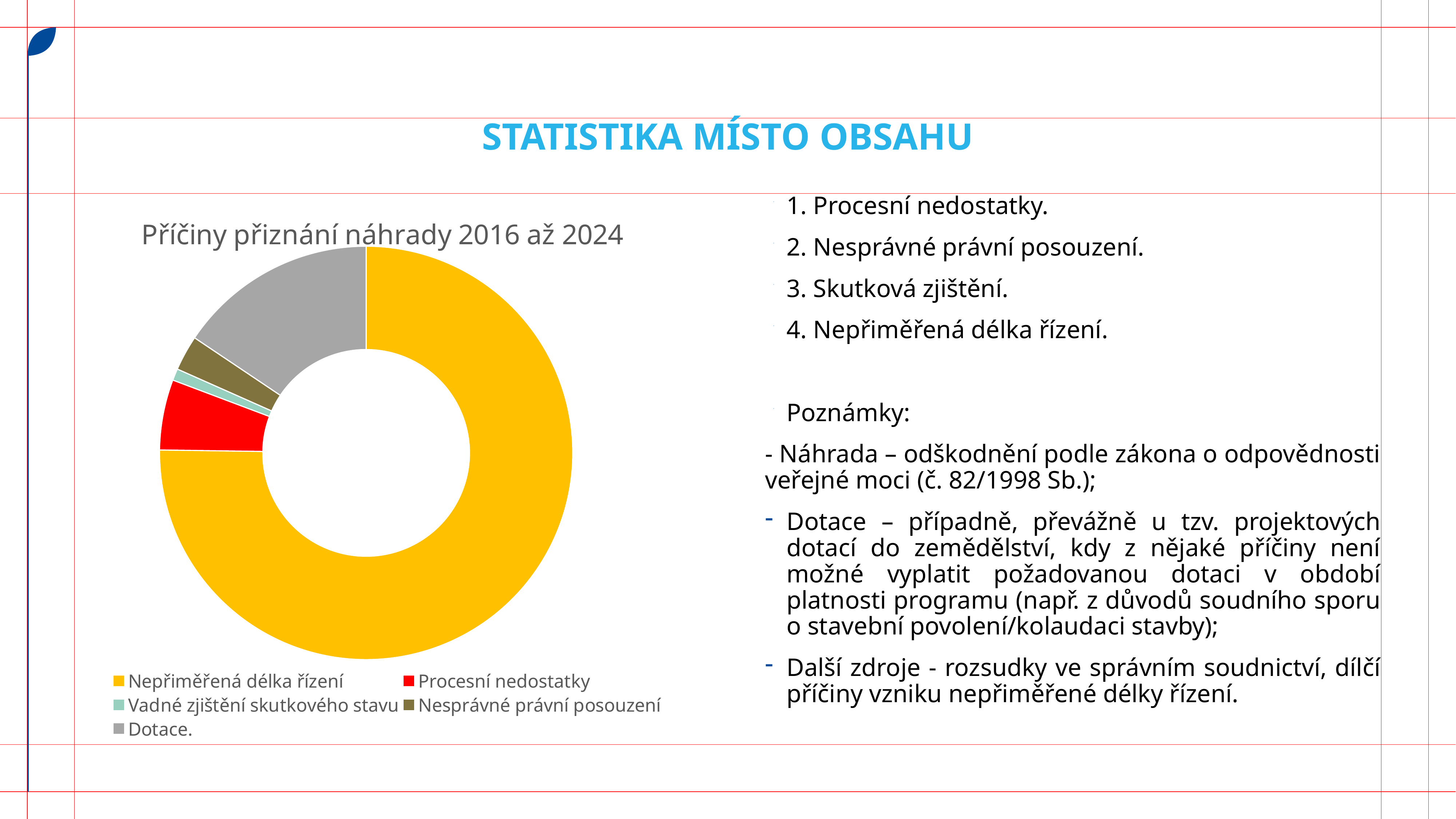
Which has the larger share: Procesní nedostatky or Nesprávné právní posouzení? Procesní nedostatky What is the title of the chart? Příčiny přiznání náhrady 2016 až 2024 Which category has the second-largest share of the chart? Dotace. What kind of chart is shown on the slide? Pie chart (doughnut) Which has the larger share: Nepřiměřená délka řízení or Dotace.? Nepřiměřená délka řízení Which has the larger share: Dotace. or Procesní nedostatky? Dotace. How many categories does the chart show? 5 Which category has the smallest share of the chart? Vadné zjištění skutkového stavu Which category is shown in red in the chart? Procesní nedostatky Which category has the largest share of the chart? Nepřiměřená délka řízení